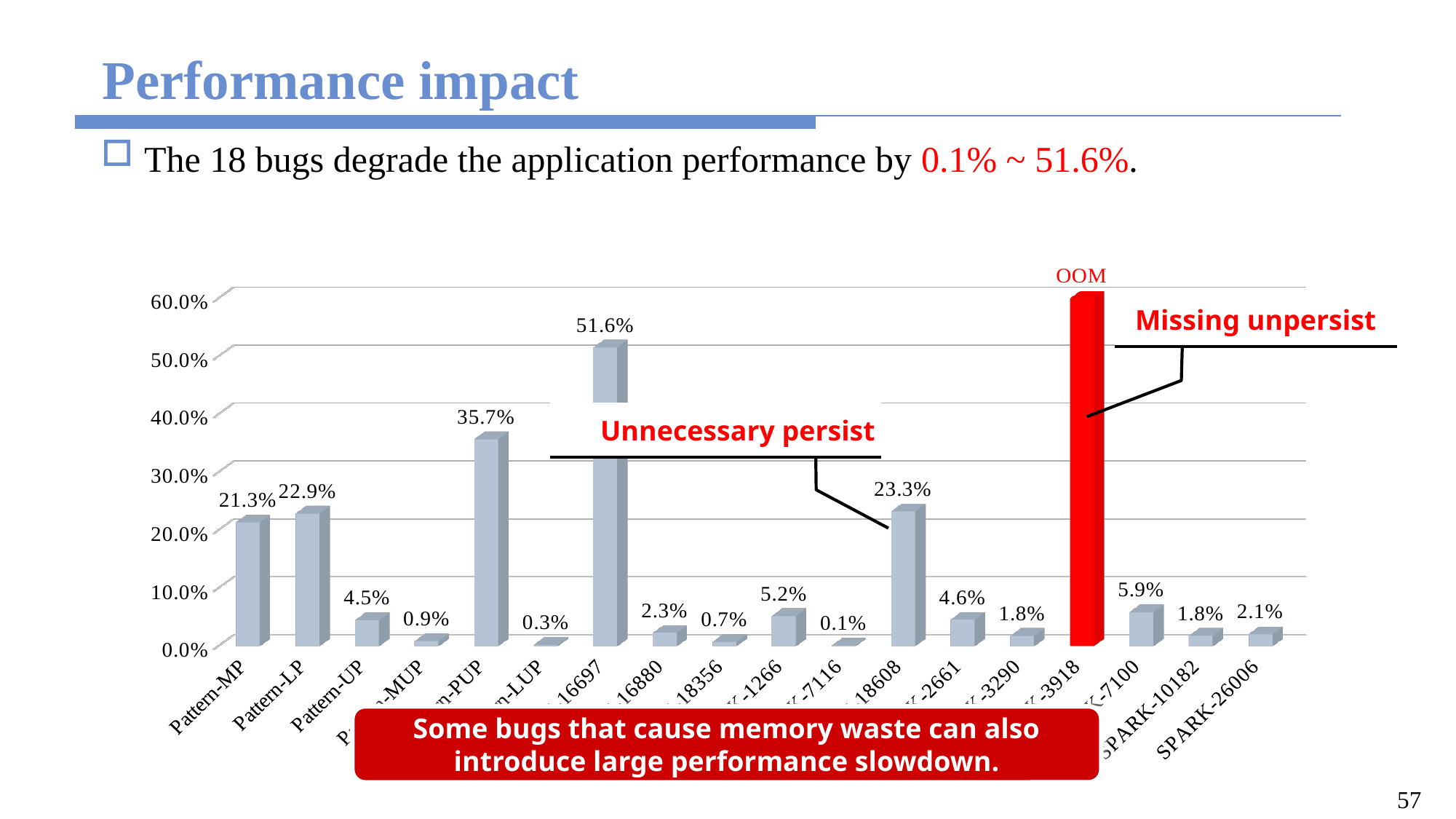
Which is larger, the value for Pattern-LP or the value for Pattern-UP? Pattern-LP What is the value for Pattern-MP? 21.3% What is the value for SPARK-26006? 2.1% Is the value for Pattern-UP greater or less than 10%? less What is the value for Pattern-UP? 4.5% What is the value for SPARK-10182? 1.8% What is the difference between the values for Pattern-LP and Pattern-MP? 1.6% What is the value for Pattern-LP? 22.9% What is the largest percentage value labeled on the chart? 51.6% What kind of chart is shown on the slide? bar chart What label is printed above the red bar? OOM What is the smallest percentage value labeled on the chart? 0.1%